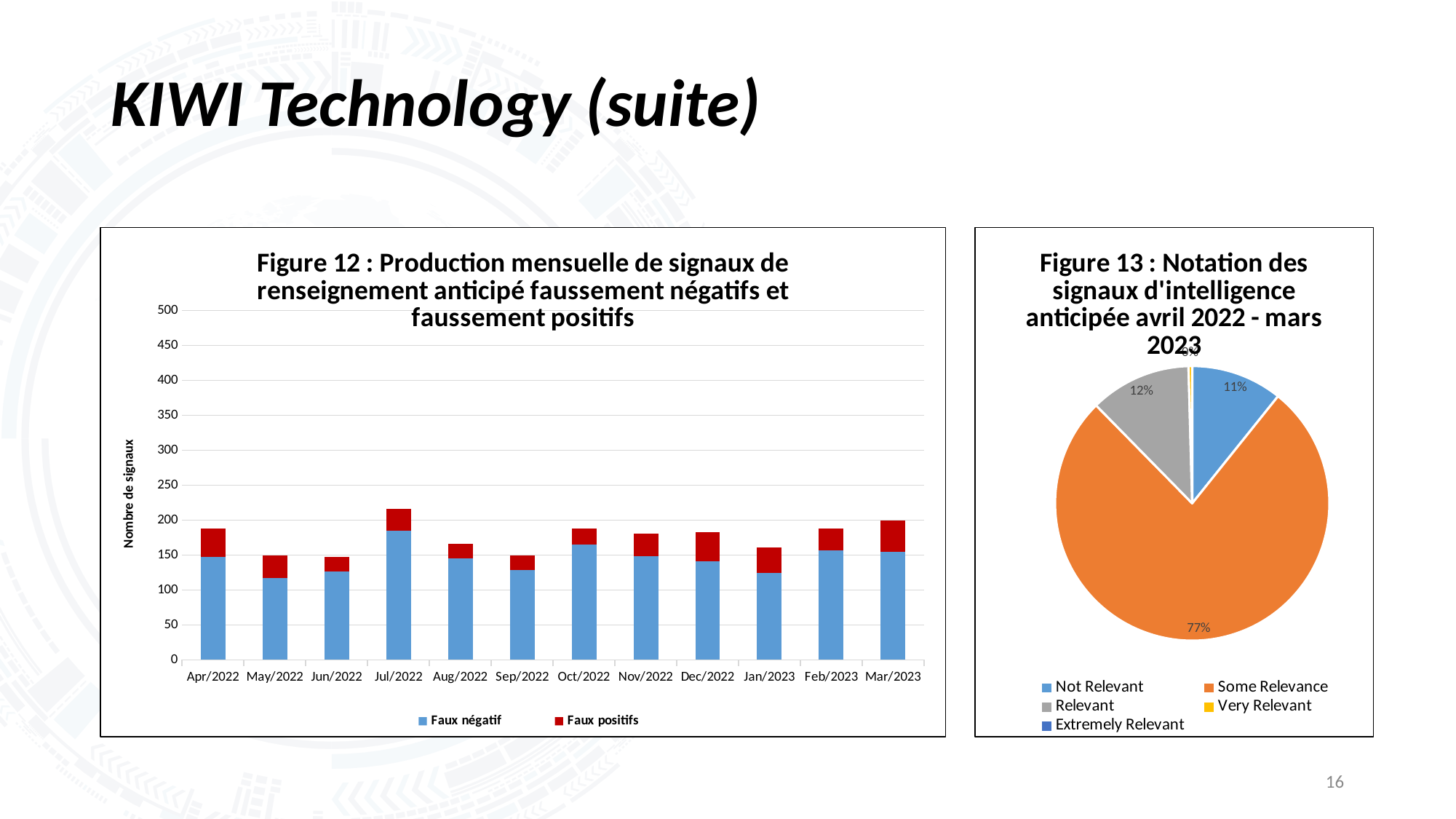
In Figure 12, how many series does the legend list? 2 In Figure 13, which category has the largest slice? Some Relevance In Figure 12, is the Faux négatif value for Jul/2022 greater or less than 150? greater In Figure 12, is the Faux négatif value for May/2022 greater or less than 150? less In Figure 12, which month has the highest total number of signals? Jul/2022 In Figure 13, what is the difference between the Some Relevance share and the Relevant share? 65 percentage points In Figure 12, is the total value for Jul/2022 greater or less than 200? greater In Figure 12, how many months are shown on the x axis? 12 What kind of chart is Figure 13? pie chart In Figure 12, what is the label of the y axis? Nombre de signaux In Figure 13, what share of the pie is Some Relevance? 77% What kind of chart is Figure 12? bar chart